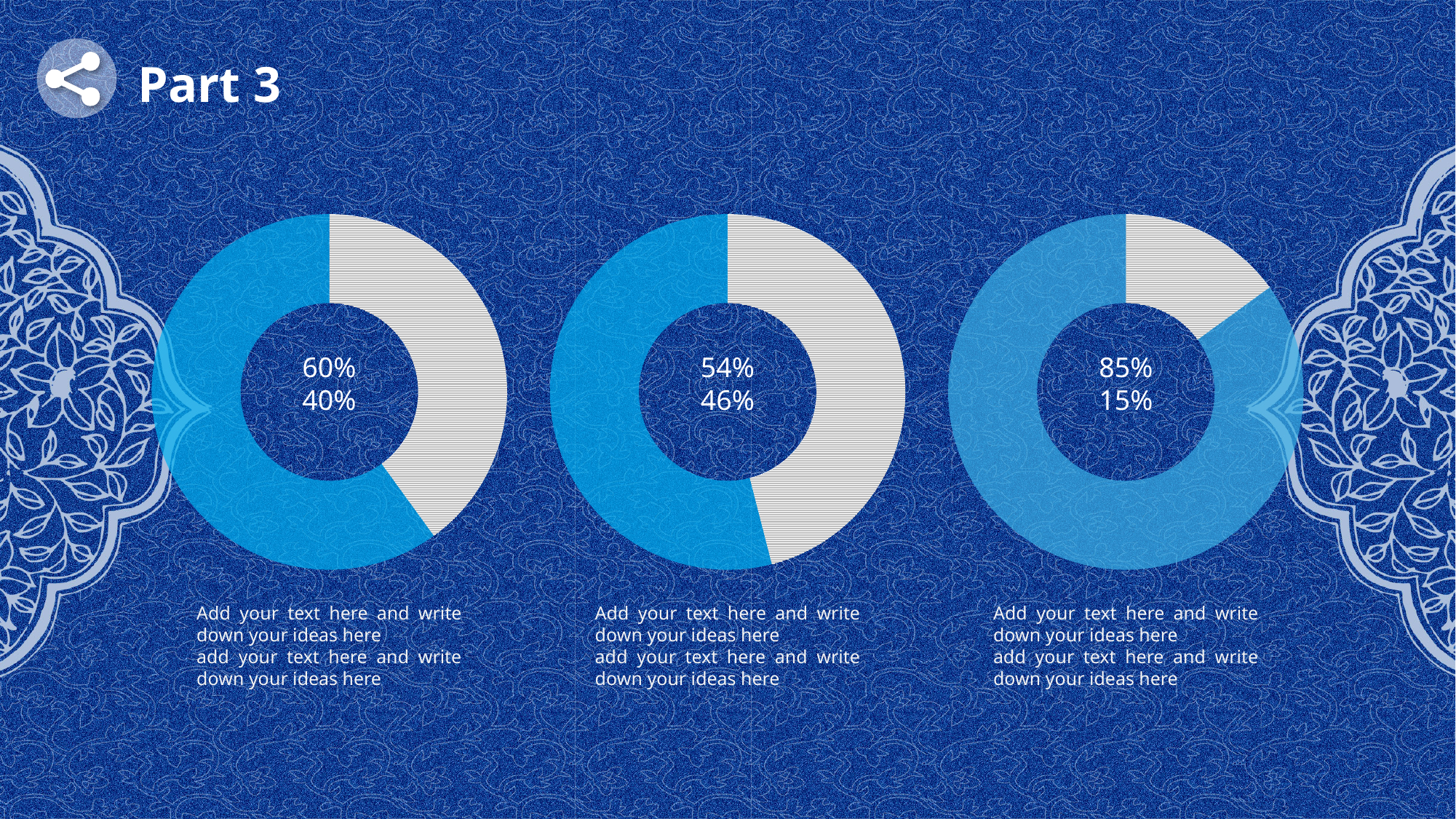
In the middle donut chart, what share does the white striped slice represent? 46% In the middle donut chart, what share does the blue slice represent? 54% Which of the three donut charts has the largest blue slice? The right chart How many donut charts are on the slide? 3 In the right donut chart, what is the difference between the blue slice and the white striped slice? 70% In the right donut chart, what share does the white striped slice represent? 15% In the middle donut chart, which slice is larger, the blue one or the white striped one? The blue one What kind of chart is shown on the left of the slide? Donut (pie) chart Which of the three donut charts has the smallest blue slice? The middle chart